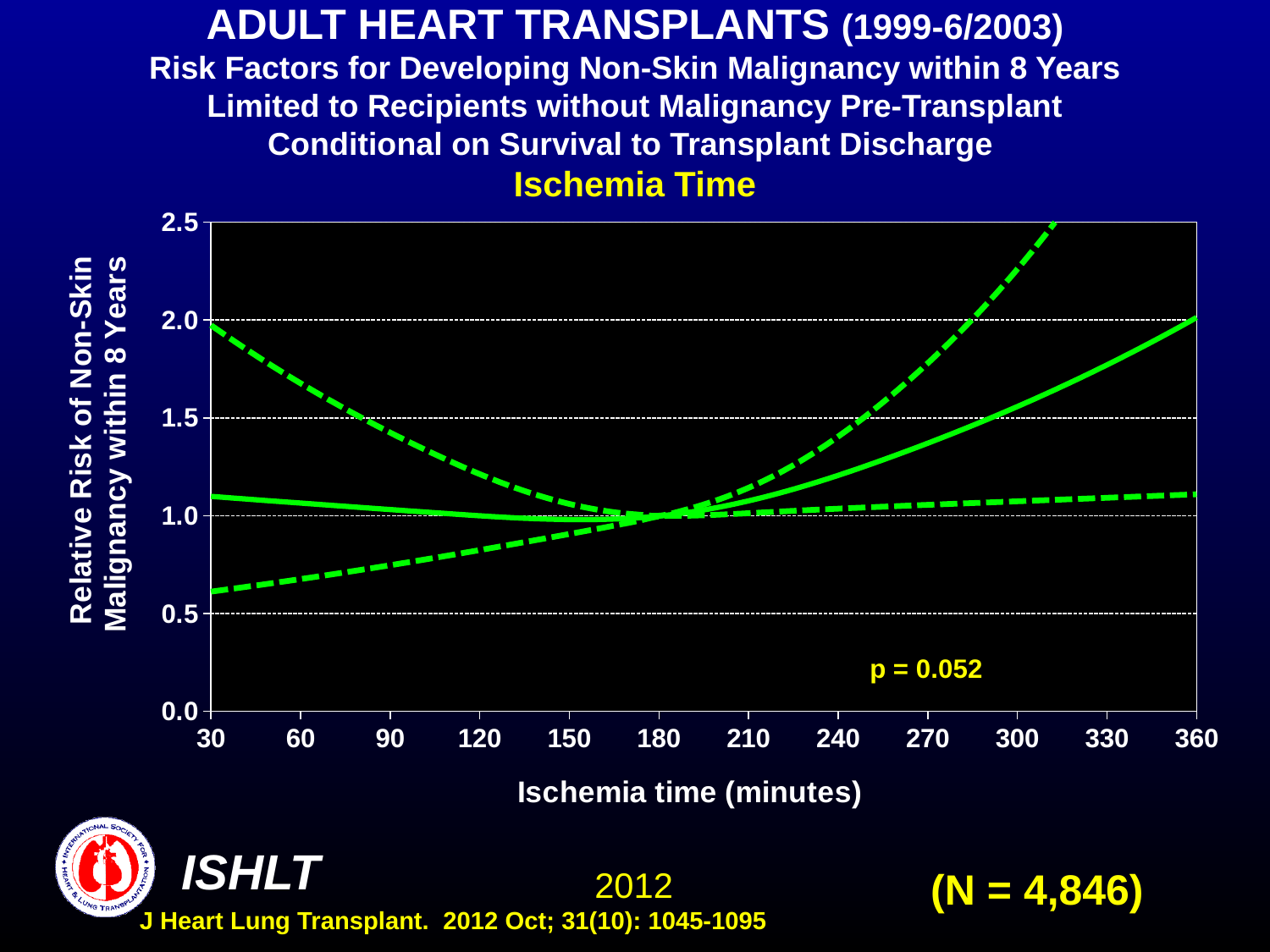
Is the value of the lower dashed line at 30 minutes greater or less than 1.0? less Does the solid line rise or fall between 180 and 360 minutes of ischemia time? rises Is the value of the solid line at 240 minutes greater or less than 1.5? less How many tick labels are shown on the x axis (Ischemia time)? 12 What is the sample size (N) shown on the slide? N = 4,846 How many lines are plotted on the chart? 3 What kind of chart is shown on the slide? line chart What p-value is printed on the chart? p = 0.052 Which is larger for the solid line: the value at 30 minutes or the value at 360 minutes? 360 minutes Is the value of the upper dashed line at 300 minutes greater or less than 2.0? greater